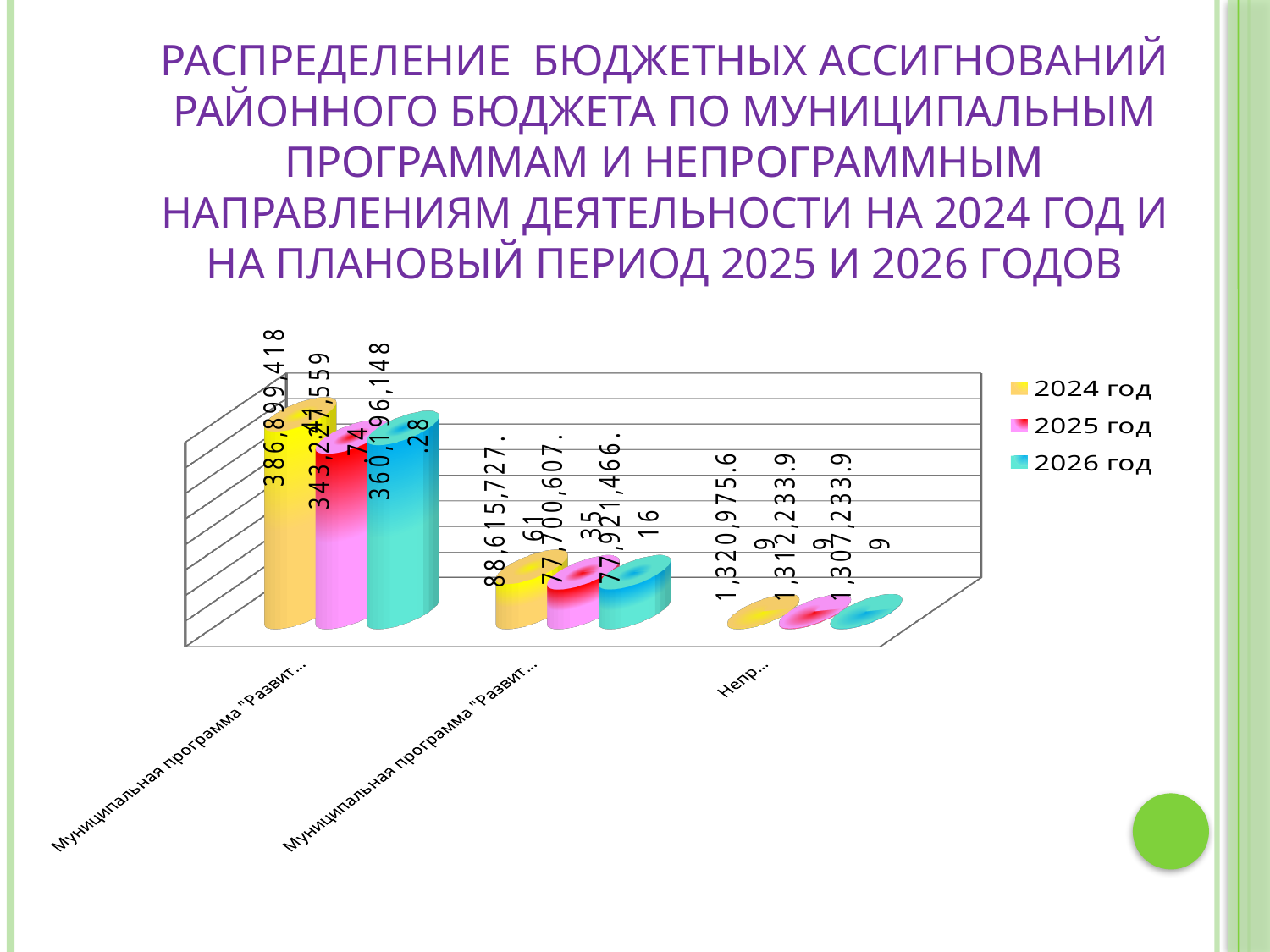
In the leftmost category group, which is larger: the 2024 год bar or the 2025 год bar? 2024 год What is the value of the 2025 год bar in the middle category group? 77,700,607.35 Which category group has the highest values across all three years? the leftmost group (Муниципальная программа "Развит...") What is the value of the 2026 год bar in the middle category group? 77,921,466.16 What is the value of the 2024 год bar in the middle category group? 88,615,727.61 How many series does the chart legend list? 3 What kind of chart is shown on the slide? bar chart What is the value of the 2024 год bar in the leftmost category group? 386,899,418.41 How many category groups are plotted along the x axis of the chart? 3 Which category group has the lowest values across all three years? the rightmost group (Непр...) Which years are listed in the chart legend? 2024 год, 2025 год, 2026 год Which colour represents the 2026 год series in the chart? teal (blue-green)